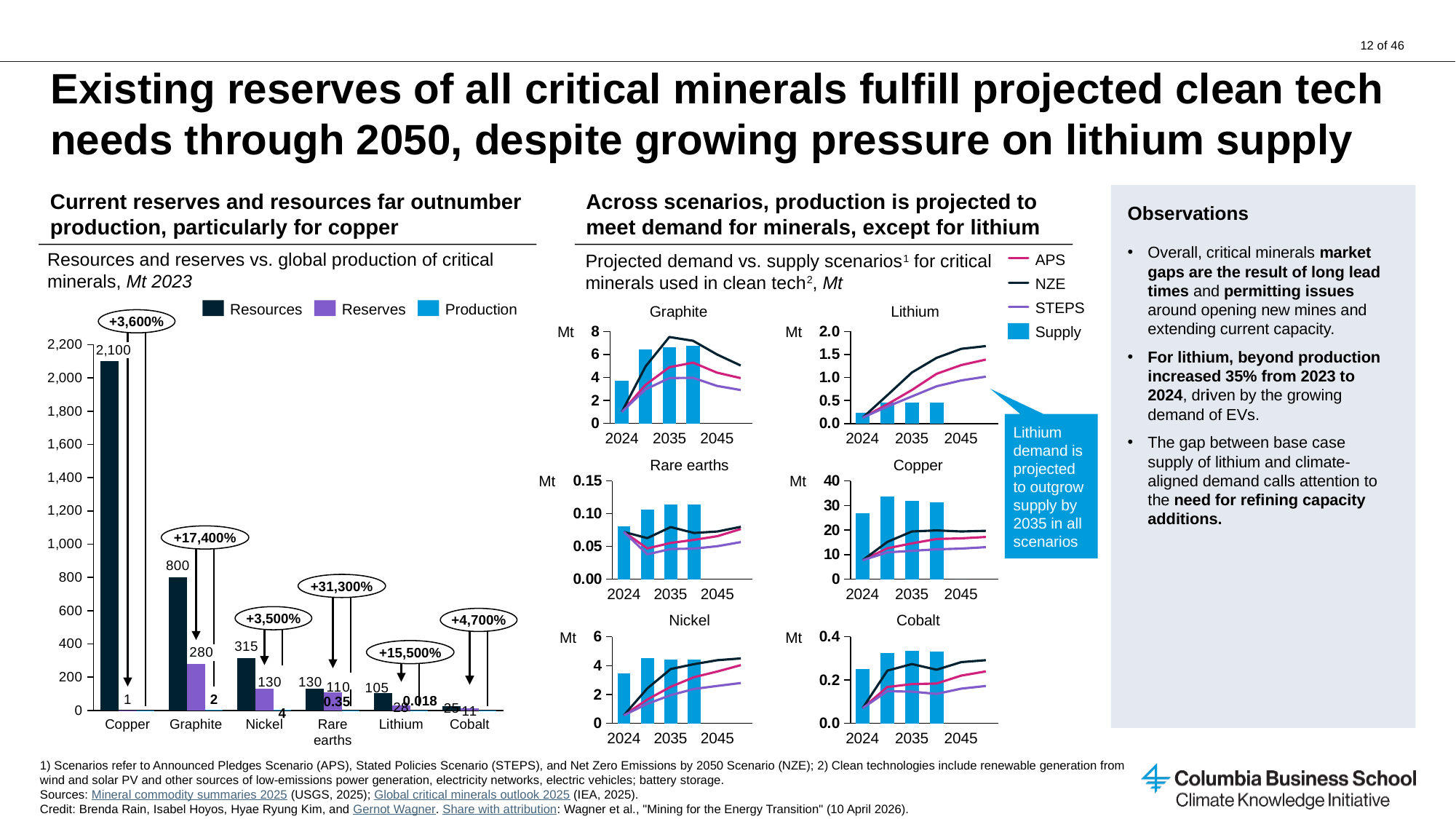
In the left chart (Resources and reserves vs. global production), what is the Resources value for Copper? 2,100 How many entries does the legend of the right-hand charts (Projected demand vs. supply scenarios) list? 4 In the left chart (Resources and reserves vs. global production), which mineral has the highest Resources value? Copper In the left chart (Resources and reserves vs. global production), what is the Reserves value for Graphite? 280 In the left chart (Resources and reserves vs. global production), what is the Production value for Rare earths? 0.35 What kind of chart is the left chart (Resources and reserves vs. global production)? Bar chart In the left chart (Resources and reserves vs. global production), which is larger, the Resources value for Nickel or for Rare earths? Nickel In the Copper chart on the right (Projected demand vs. supply scenarios), is the Supply value for 2024 greater or less than 20? greater How many minerals are shown on the x axis of the left chart (Resources and reserves vs. global production)? 6 In the left chart (Resources and reserves vs. global production), what is the difference between the Resources and Reserves values for Graphite? 520 How many series does the legend of the left chart (Resources and reserves vs. global production) list? 3 In the left chart (Resources and reserves vs. global production), what is the Resources value for Nickel? 315